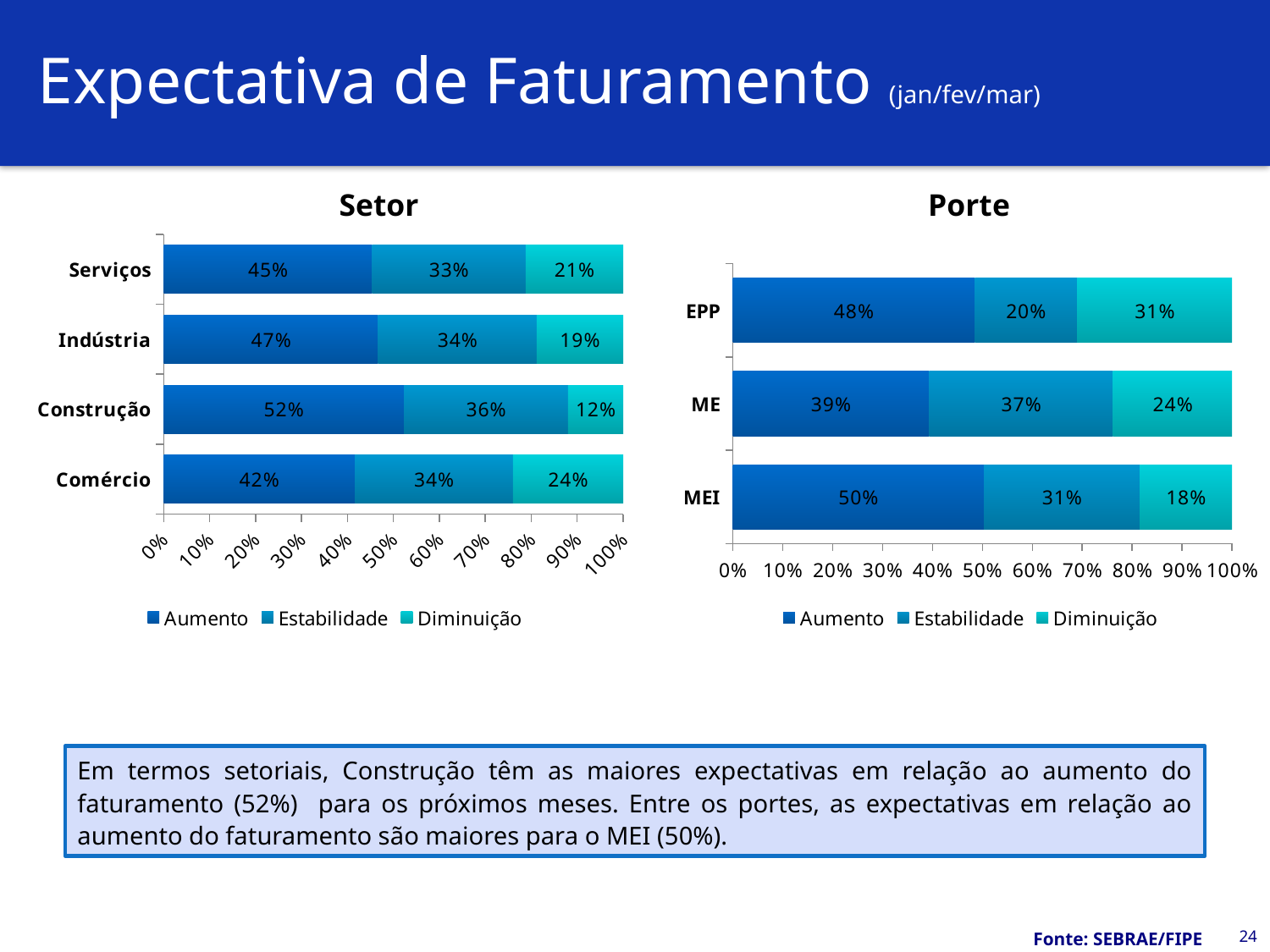
How many categories are shown in the 'Porte' chart? 3 In the 'Setor' chart, which sector has the lowest Diminuição value? Construção In the 'Setor' chart, what is the Aumento value for Construção? 52% In the 'Porte' chart, what is the Aumento value for MEI? 50% What type of chart is the 'Setor' chart? Stacked bar chart In the 'Porte' chart, which category has the lowest Aumento value? ME In the 'Porte' chart, what is the Estabilidade value for ME? 37% In the 'Setor' chart, is the Aumento value for Indústria or for Comércio larger? Indústria In the 'Setor' chart, what is the Diminuição value for Comércio? 24% How many series does the legend of the 'Setor' chart list? 3 In the 'Setor' chart, which sector has the highest Aumento value? Construção In the 'Porte' chart, what is the difference between the Diminuição values for EPP and MEI? 13%